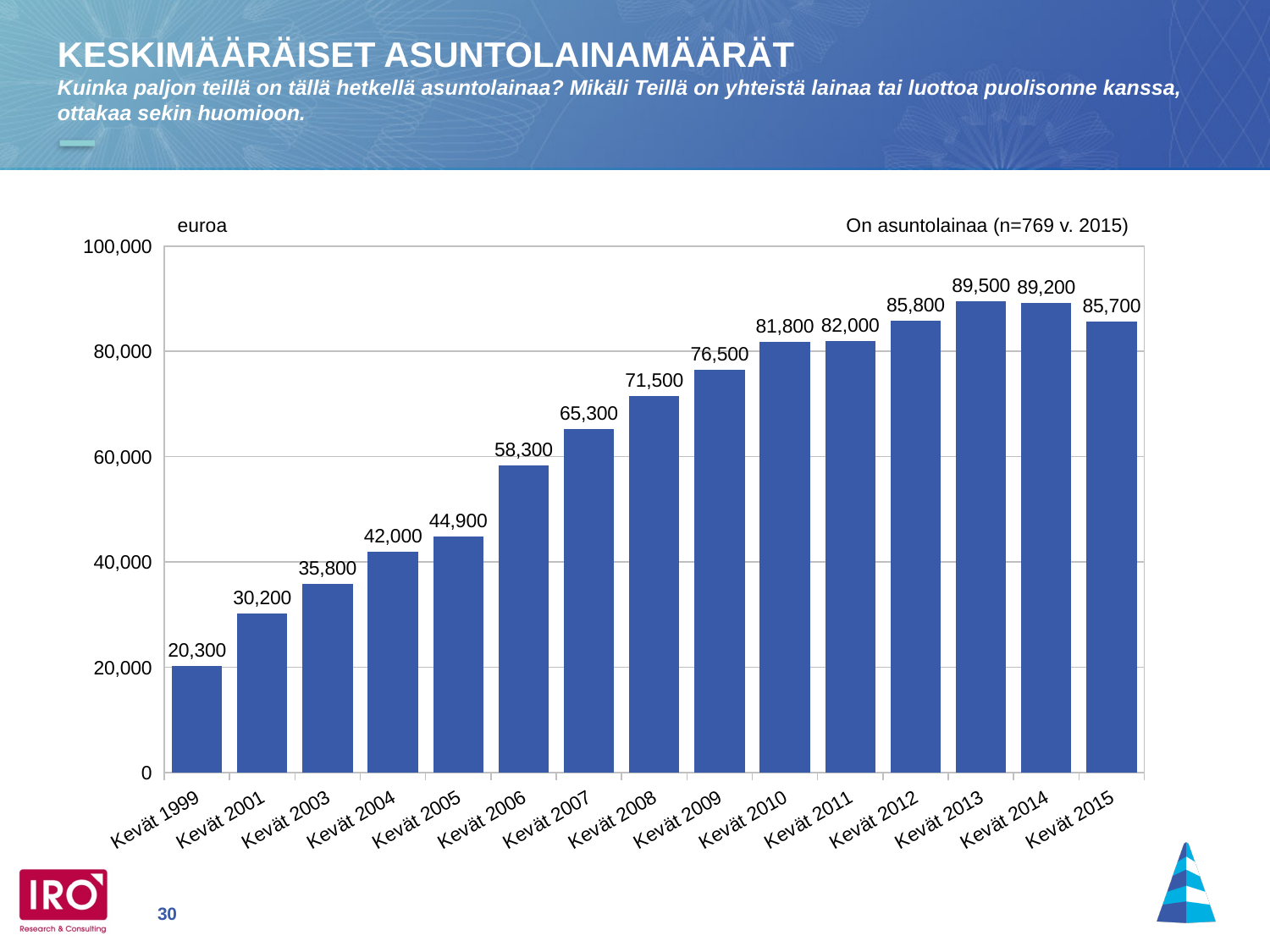
Which category has the highest value? Kevät 2013 What is the value for Kevät 1999? 20,300 Which is larger, the value for Kevät 2012 or the value for Kevät 2015? Kevät 2012 What is the value for Kevät 2006? 58,300 What unit label is shown above the y axis? euroa What is the value for Kevät 2015? 85,700 What is the difference between the values for Kevät 2009 and Kevät 2008? 5,000 What kind of chart is shown on the slide? bar chart How many categories are shown on the x axis? 15 Which category has the lowest value? Kevät 1999 What is the difference between the values for Kevät 2013 and Kevät 1999? 69,200 Is the value for Kevät 2007 greater or less than 60,000? greater